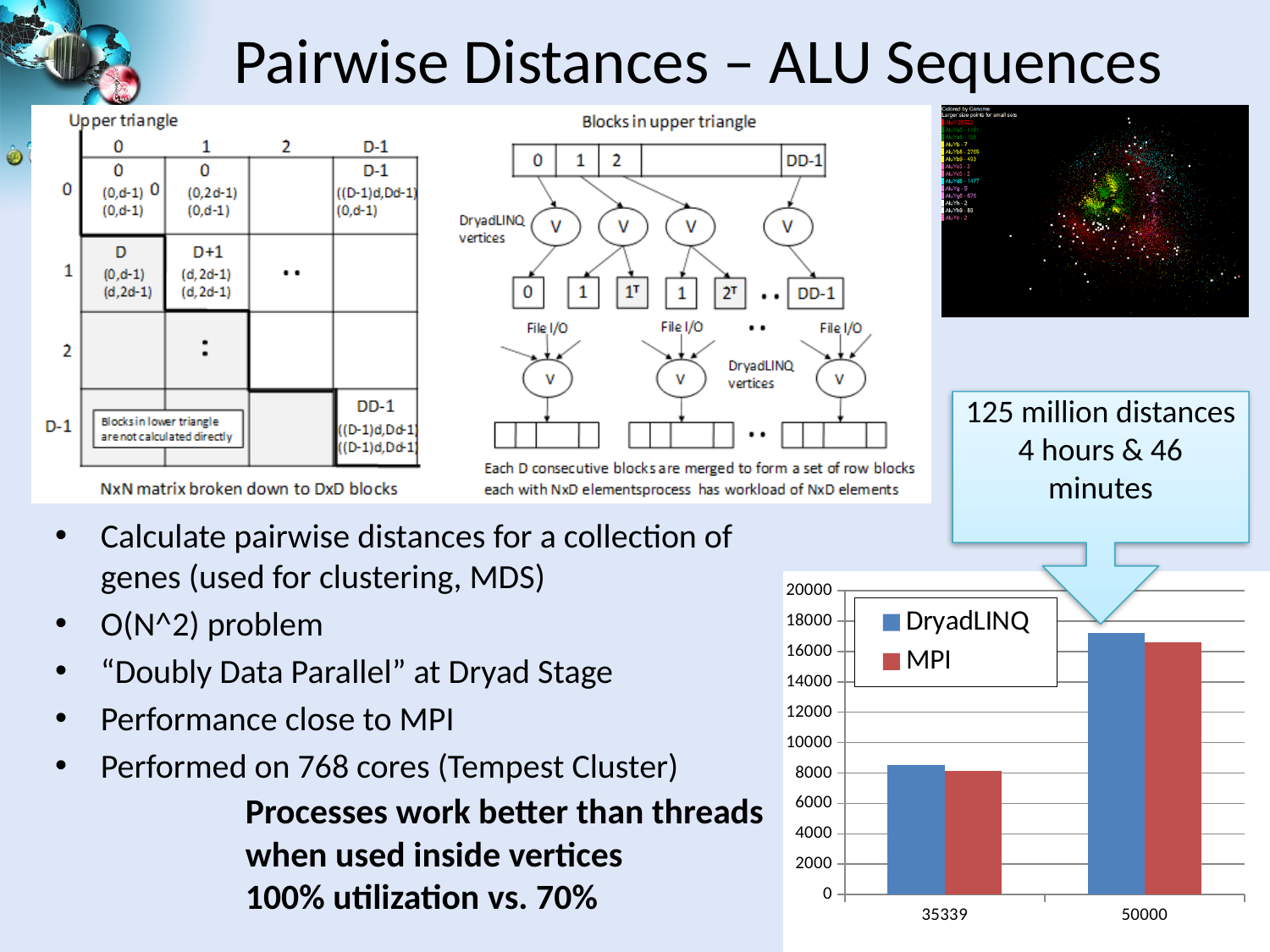
What are the two series named in the bar chart's legend? DryadLINQ and MPI What are the category labels on the x axis of the bar chart? 35339 and 50000 In the bar chart, is the MPI value for 35339 greater or less than 10000? less What kind of chart is shown at the bottom right of the slide? bar chart In the bar chart, is the DryadLINQ value for 35339 greater or less than 8000? greater In the bar chart, which series has the larger value for 50000, DryadLINQ or MPI? DryadLINQ How many categories are shown on the x axis of the bar chart? 2 How many series does the legend of the bar chart list? 2 In the bar chart, is the MPI value for 50000 greater or less than 14000? greater In the bar chart, which category has the highest DryadLINQ value? 50000 In the bar chart, do the values rise or fall from 35339 to 50000? rise